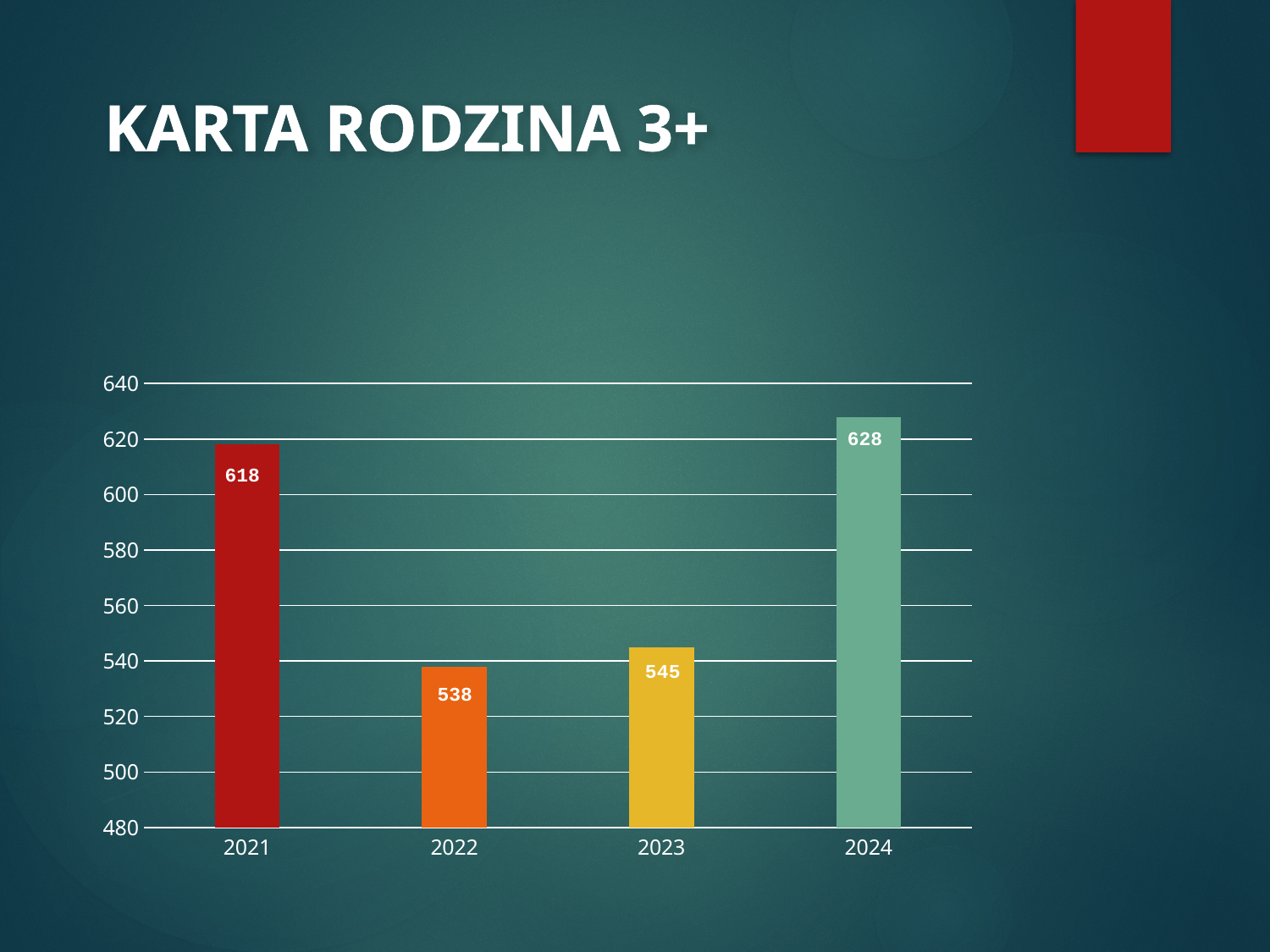
Which year has the lowest value? 2022 Which year has the highest value? 2024 What is the difference between the values for 2024 and 2021? 10 Which is larger, the value for 2021 or the value for 2023? 2021 How many years are shown on the x axis? 4 What is the value for 2024? 628 Is the value for 2022 greater or less than 560? less What is the value for 2022? 538 What is the difference between the values for 2023 and 2022? 7 What is the value for 2021? 618 What kind of chart is shown on the slide? bar chart What is the value for 2023? 545